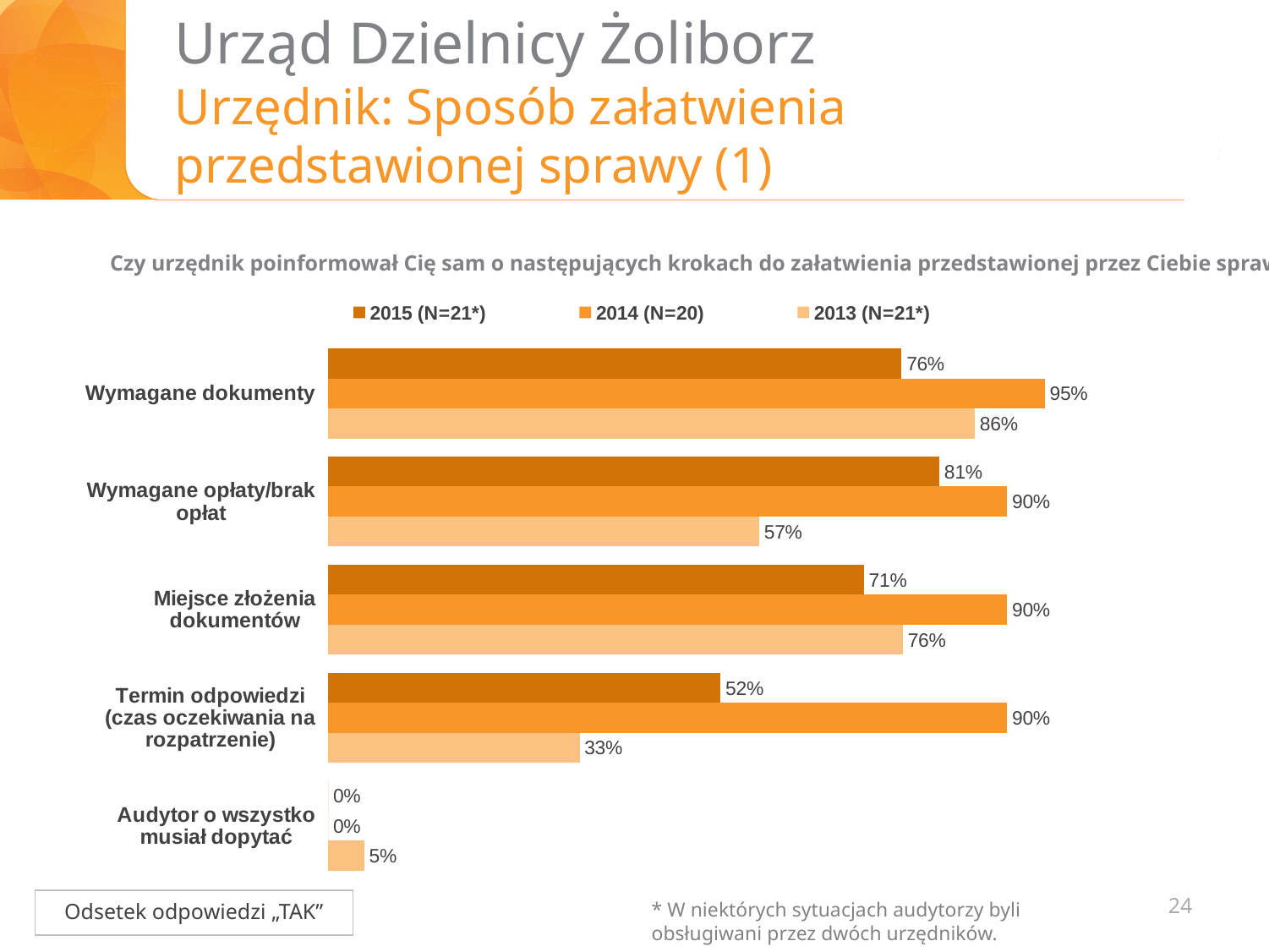
What is the value for 'Wymagane opłaty/brak opłat' in the 2015 (N=21*) series? 81% How many series does the legend list? 3 Which series is shown in the darkest orange colour in the legend? 2015 (N=21*) What is the value for 'Termin odpowiedzi (czas oczekiwania na rozpatrzenie)' in the 2013 (N=21*) series? 33% What is the value for 'Audytor o wszystko musiał dopytać' in the 2014 (N=20) series? 0% What is the difference between the 2014 (N=20) and 2015 (N=21*) values for 'Termin odpowiedzi (czas oczekiwania na rozpatrzenie)'? 38 percentage points Which category has the lowest value in the 2013 (N=21*) series? Audytor o wszystko musiał dopytać How many categories are shown on the chart? 5 What is the value for 'Wymagane dokumenty' in the 2014 (N=20) series? 95% Which is larger for 'Miejsce złożenia dokumentów': the 2015 (N=21*) value or the 2013 (N=21*) value? 2013 (N=21*) What kind of chart is shown on the slide? Bar chart Which category has the highest value in the 2015 (N=21*) series? Wymagane opłaty/brak opłat